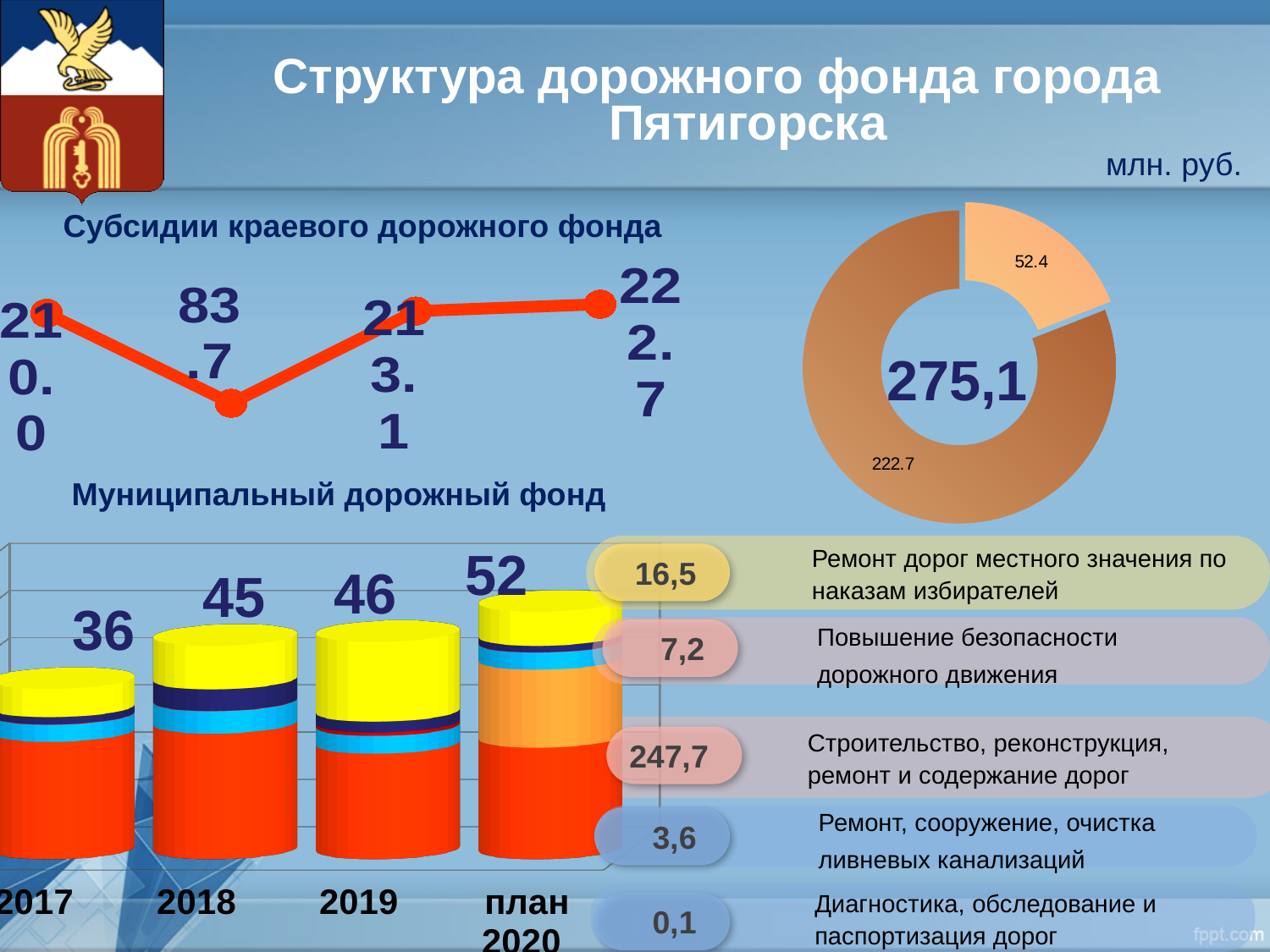
In the bar chart 'Муниципальный дорожный фонд', which category has the highest value? план 2020 In the bar chart 'Муниципальный дорожный фонд', what is the value for план 2020? 52 In the bar chart 'Муниципальный дорожный фонд', what is the difference between the values for план 2020 and 2017? 16 In the line chart 'Субсидии краевого дорожного фонда', which point has the lowest value? the second point (83.7) How many categories are shown in the bar chart 'Муниципальный дорожный фонд'? 4 In the bar chart 'Муниципальный дорожный фонд', which category has the lowest value? 2017 In the bar chart 'Муниципальный дорожный фонд', do the values rise or fall from 2017 to план 2020? rise In the line chart 'Субсидии краевого дорожного фонда', what is the value of the last point? 222.7 In the bar chart 'Муниципальный дорожный фонд', what is the value for 2017? 36 In the donut chart on the right, what is the value of the smaller segment? 52.4 In the donut chart on the right, what total is shown in the centre? 275,1 In the line chart 'Субсидии краевого дорожного фонда', what is the value of the second point? 83.7